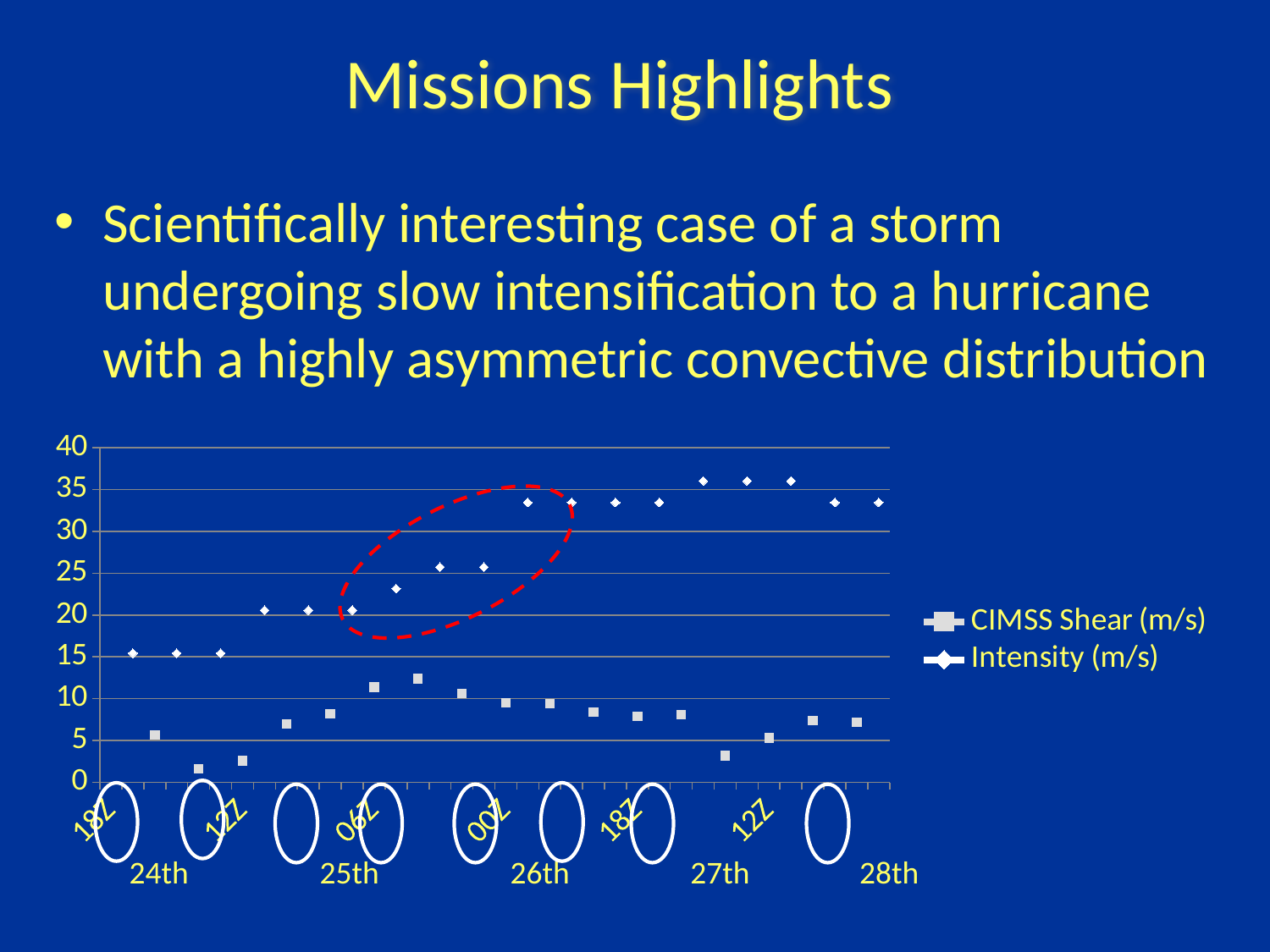
What are the two series named in the chart legend? CIMSS Shear (m/s) and Intensity (m/s) Is the leftmost Intensity (m/s) value greater or less than 10? greater Does the Intensity (m/s) series generally rise or fall from left to right along the x axis? rise Is the highest CIMSS Shear (m/s) value greater or less than 15? less What is the maximum value shown on the chart's vertical axis? 40 Is the leftmost CIMSS Shear (m/s) value greater or less than 10? less Which series has the larger values throughout the chart, CIMSS Shear (m/s) or Intensity (m/s)? Intensity (m/s) Which series is plotted with diamond markers? Intensity (m/s) How many series does the chart legend list? 2